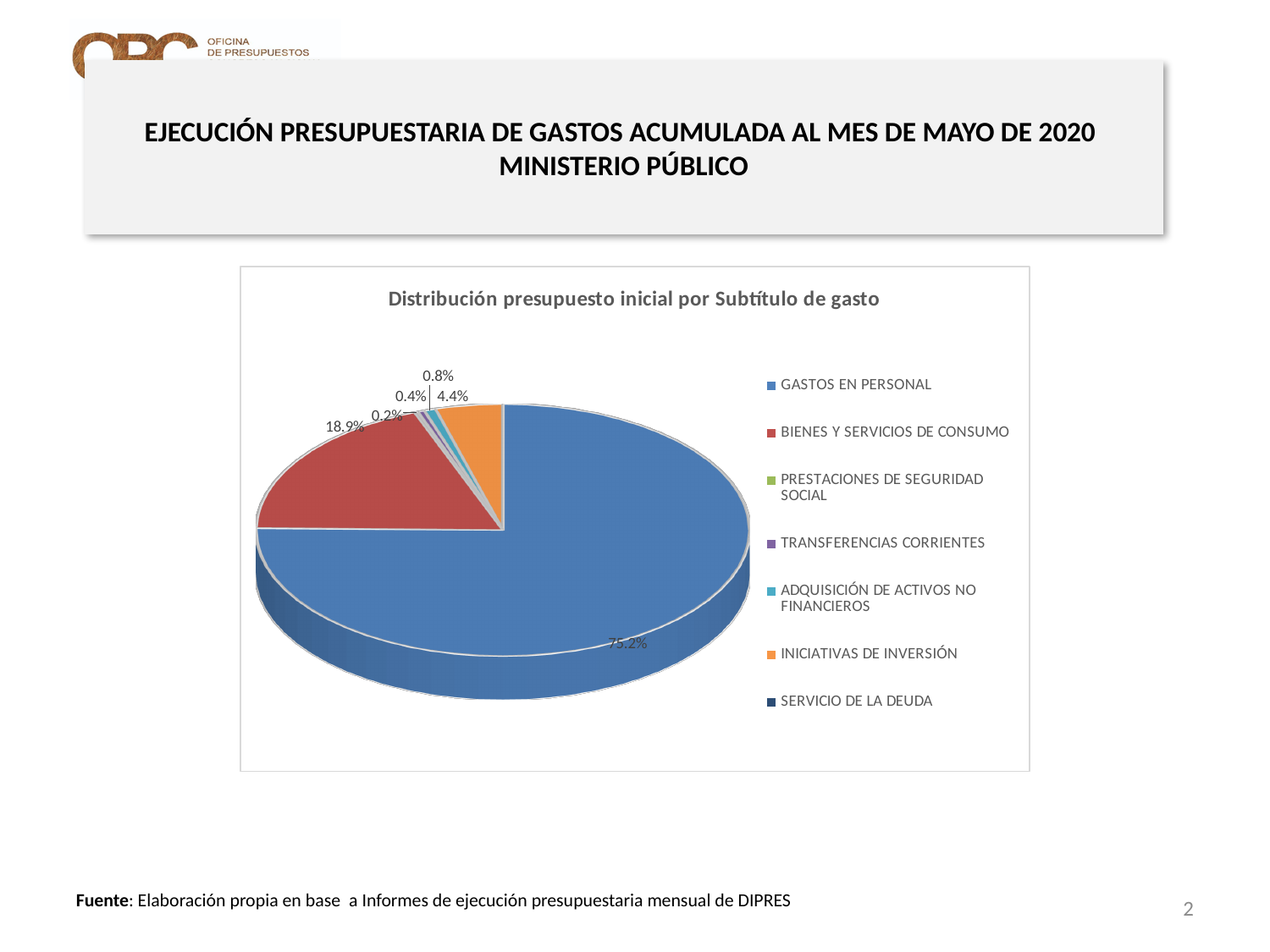
Which category has the largest slice of the pie? GASTOS EN PERSONAL What share of the pie does BIENES Y SERVICIOS DE CONSUMO represent? 18.9% What share of the pie does INICIATIVAS DE INVERSIÓN represent? 4.4% What share of the pie does GASTOS EN PERSONAL represent? 75.2% What colour is the slice for GASTOS EN PERSONAL? Blue What is the combined share of GASTOS EN PERSONAL and BIENES Y SERVICIOS DE CONSUMO? 94.1% Which is larger, the slice for GASTOS EN PERSONAL or the slice for BIENES Y SERVICIOS DE CONSUMO? GASTOS EN PERSONAL What is the title of the chart? Distribución presupuesto inicial por Subtítulo de gasto What is the difference in percentage points between the GASTOS EN PERSONAL share and the BIENES Y SERVICIOS DE CONSUMO share? 56.3 percentage points What kind of chart is shown on the slide? Pie chart How many categories does the chart's legend list? 7 Which is larger, the slice for INICIATIVAS DE INVERSIÓN or the slice for BIENES Y SERVICIOS DE CONSUMO? BIENES Y SERVICIOS DE CONSUMO